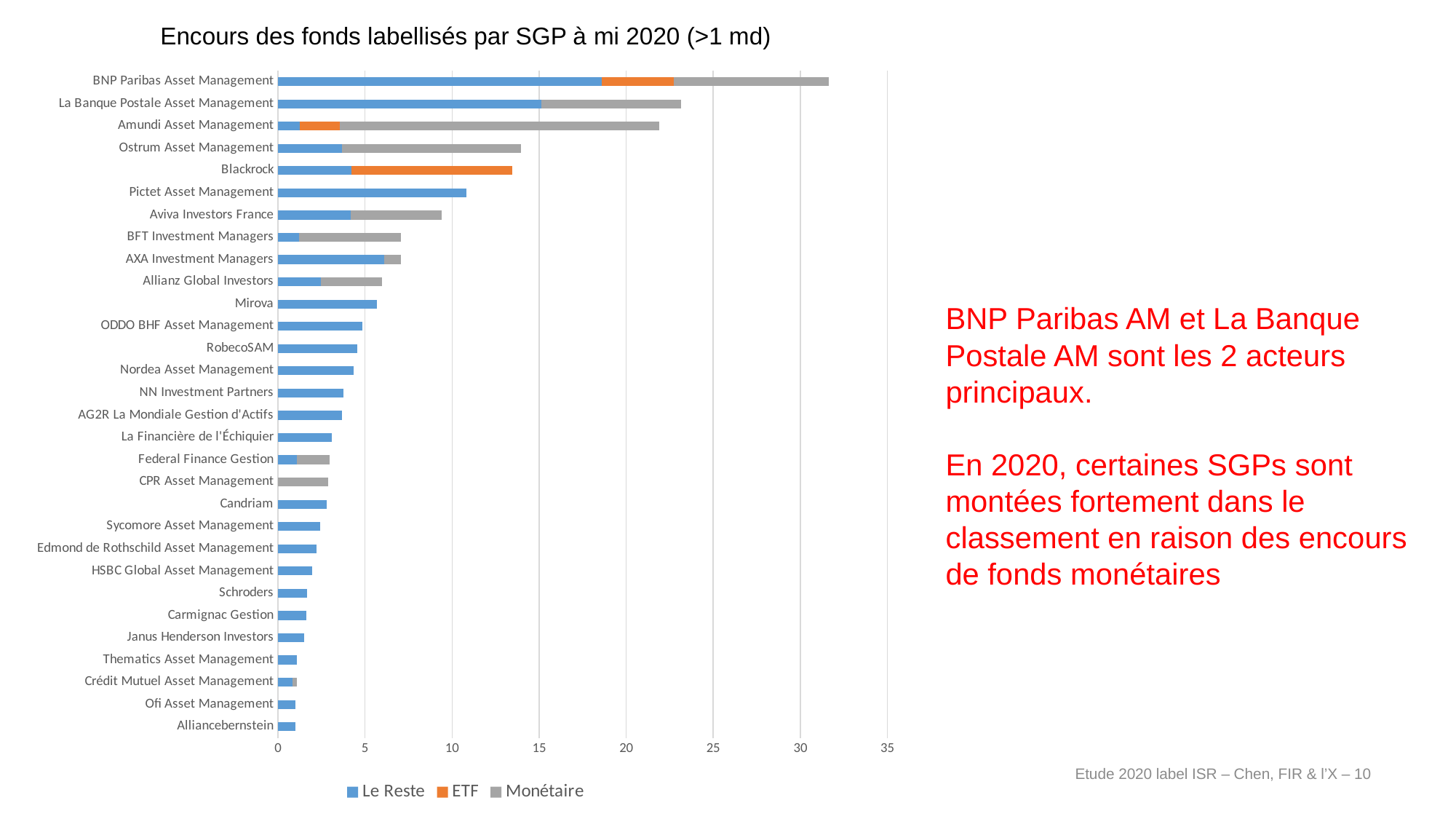
Is the total value for Pictet Asset Management greater or less than 10? greater How many series does the legend list? 3 Is the total value for La Banque Postale Asset Management greater or less than 20? greater Which has the larger total bar, Blackrock or Pictet Asset Management? Blackrock Which asset manager has the highest total bar? BNP Paribas Asset Management What kind of chart is shown on the slide? Stacked bar chart Is the total value for Aviva Investors France greater or less than 10? less Which series is shown in orange in the legend? ETF What is the title of the chart? Encours des fonds labellisés par SGP à mi 2020 (>1 md) How many asset managers (categories) are plotted on the chart? 30